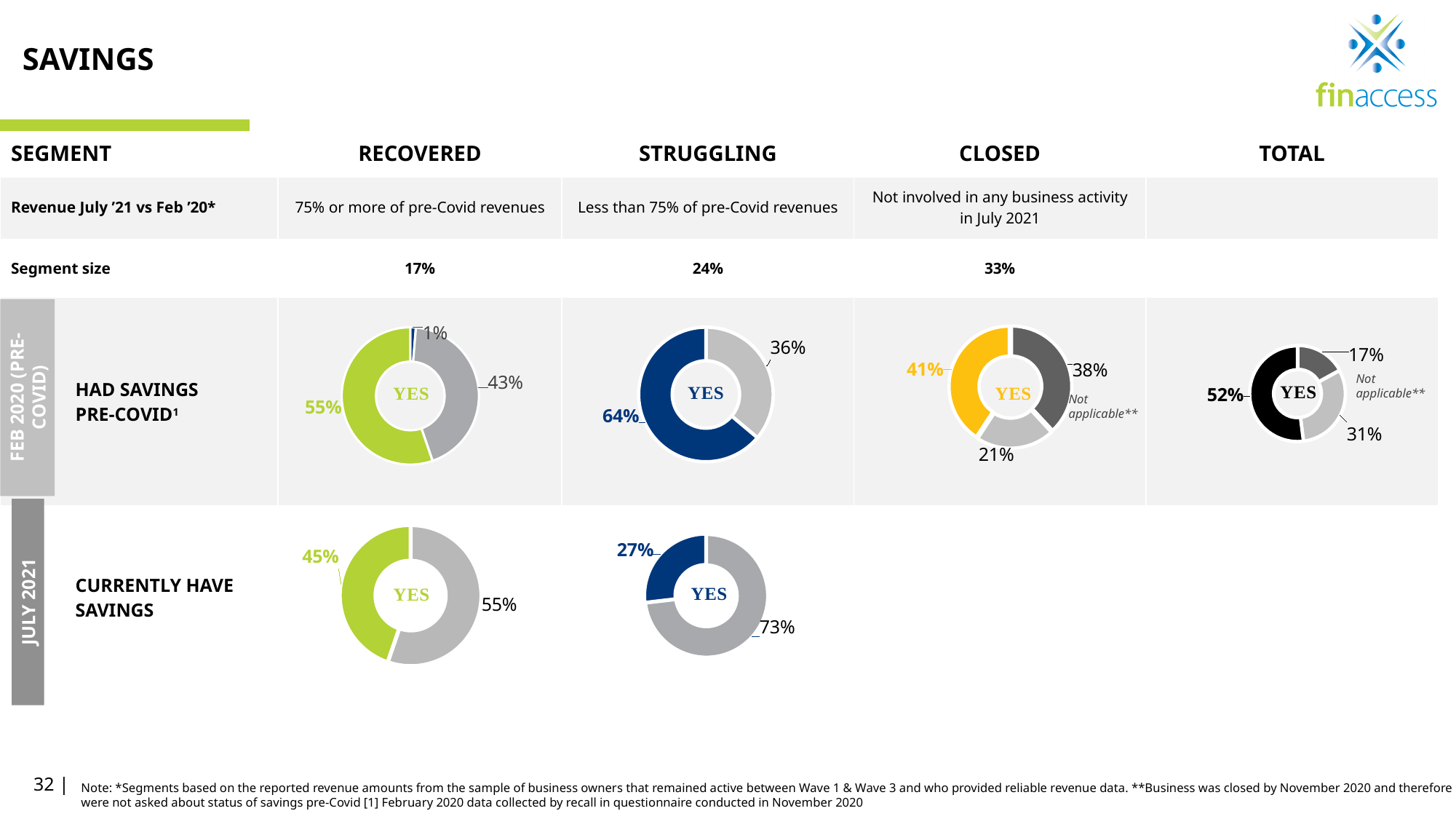
In the 'Had savings pre-Covid' donut chart for the Total column, what share answered YES? 52% In the 'Had savings pre-Covid' donut chart for the Struggling segment, what share answered YES? 64% How many donut charts are shown on the slide in total? 6 Which segment has the higher YES share in the 'Had savings pre-Covid' row: Recovered or Struggling? Struggling What type of chart is used to show savings status on this slide? Donut (pie) chart How many slices does the 'Had savings pre-Covid' donut chart for the Closed segment have? 3 In the 'Had savings pre-Covid' donut chart for the Recovered segment, what share answered YES? 55% In the 'Had savings pre-Covid' donut chart for the Closed segment, what share is labelled 'Not applicable'? 38% In the 'Had savings pre-Covid' donut chart for the Recovered segment, what is the smallest slice's value? 1% In the 'Currently have savings' donut chart for the Struggling segment, what is the difference between the non-YES slice and the YES slice? 46% In the 'Currently have savings' donut chart for the Recovered segment, what is the larger slice's value? 55% In the 'Currently have savings' donut chart for the Struggling segment, what share answered YES? 27%